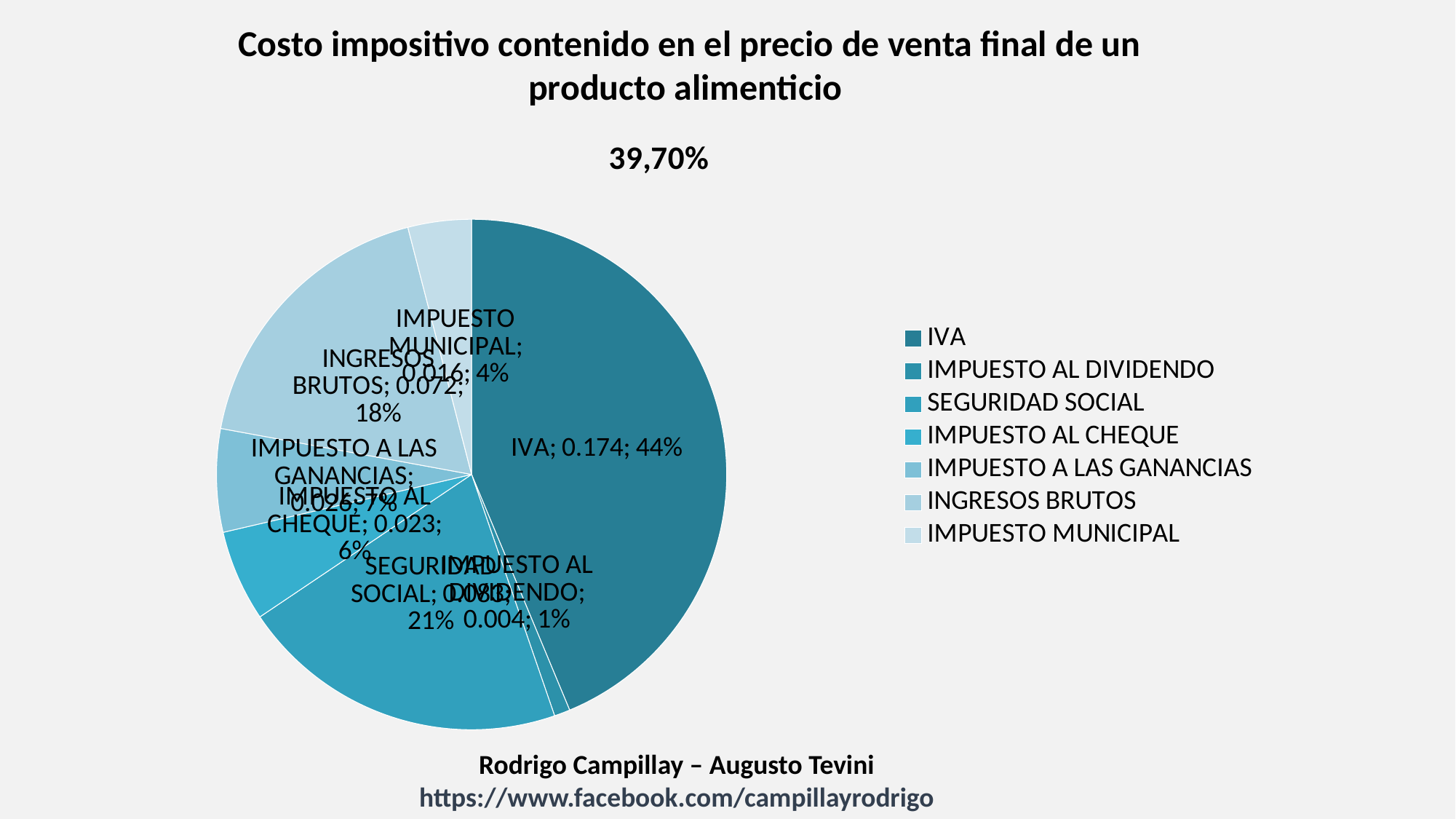
Which category has the largest slice of the pie? IVA By how many percentage points does the IVA share exceed the INGRESOS BRUTOS share? 26 percentage points What percentage share is shown for INGRESOS BRUTOS? 18% How many slices does the pie chart have? 7 What value is printed for IMPUESTO MUNICIPAL? 0.016 What title is printed directly above the pie chart? 39,70% What kind of chart is shown on the slide? Pie chart What percentage share is shown for SEGURIDAD SOCIAL? 21% Which category has the smallest slice of the pie? IMPUESTO AL DIVIDENDO What percentage share does the IVA slice represent? 44% What value is printed for IVA in the pie chart? 0.174 Which slice is larger, INGRESOS BRUTOS or IMPUESTO AL CHEQUE? INGRESOS BRUTOS